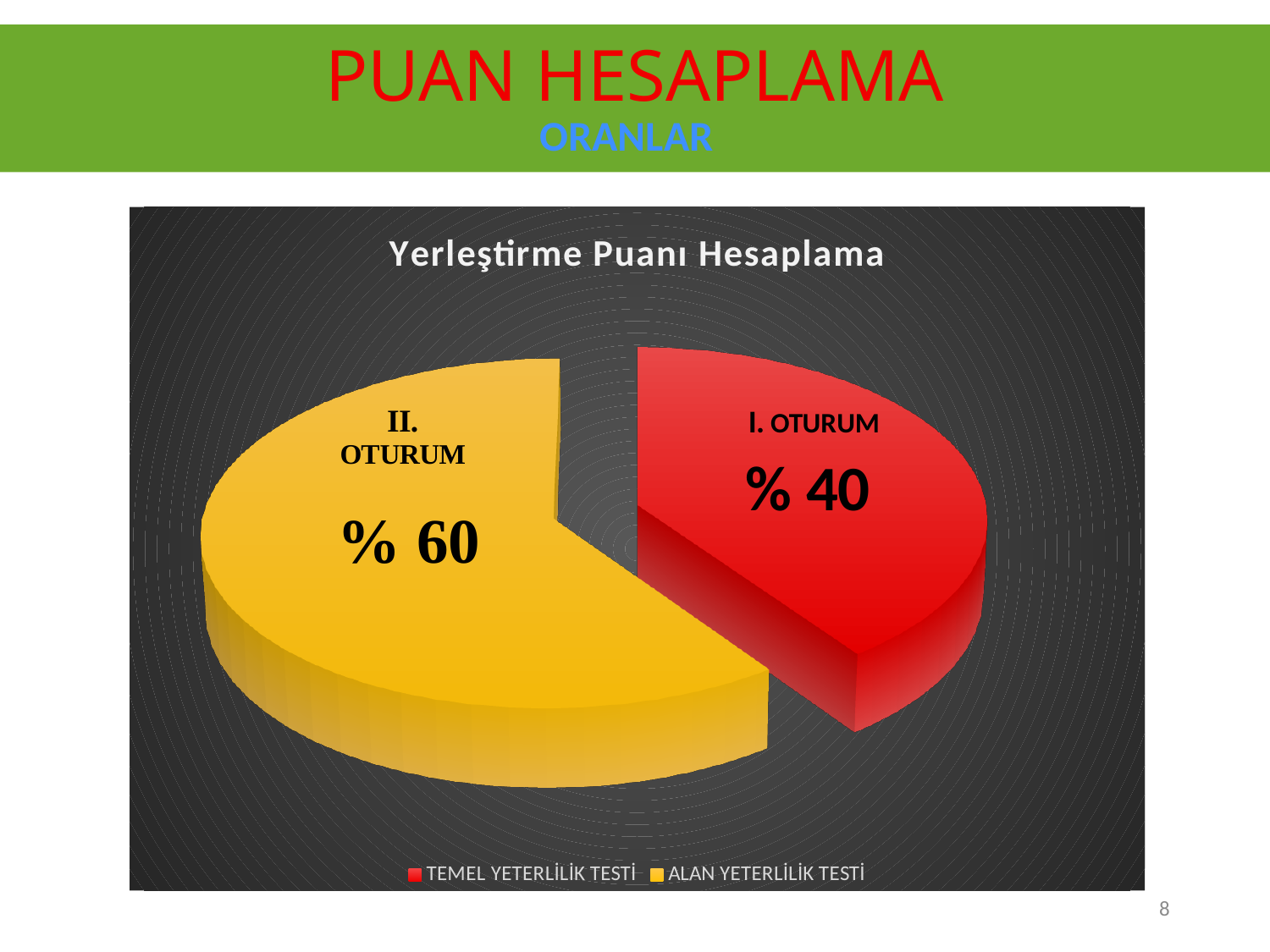
What percentage is shown for I. OTURUM? % 40 How many slices does the pie chart have? 2 Which slice of the pie is the largest? II. OTURUM Which slice of the pie is the smallest? I. OTURUM What share of the pie does the I. OTURUM slice represent? % 40 Which is larger, the I. OTURUM slice or the II. OTURUM slice? II. OTURUM What percentage is shown for II. OTURUM? % 60 What kind of chart is shown on the slide? pie chart How many entries does the legend list? 2 What is the title of the chart? Yerleştirme Puanı Hesaplama What is the difference between the II. OTURUM and I. OTURUM percentages? % 20 Which legend entry is shown in red? TEMEL YETERLİLİK TESTİ